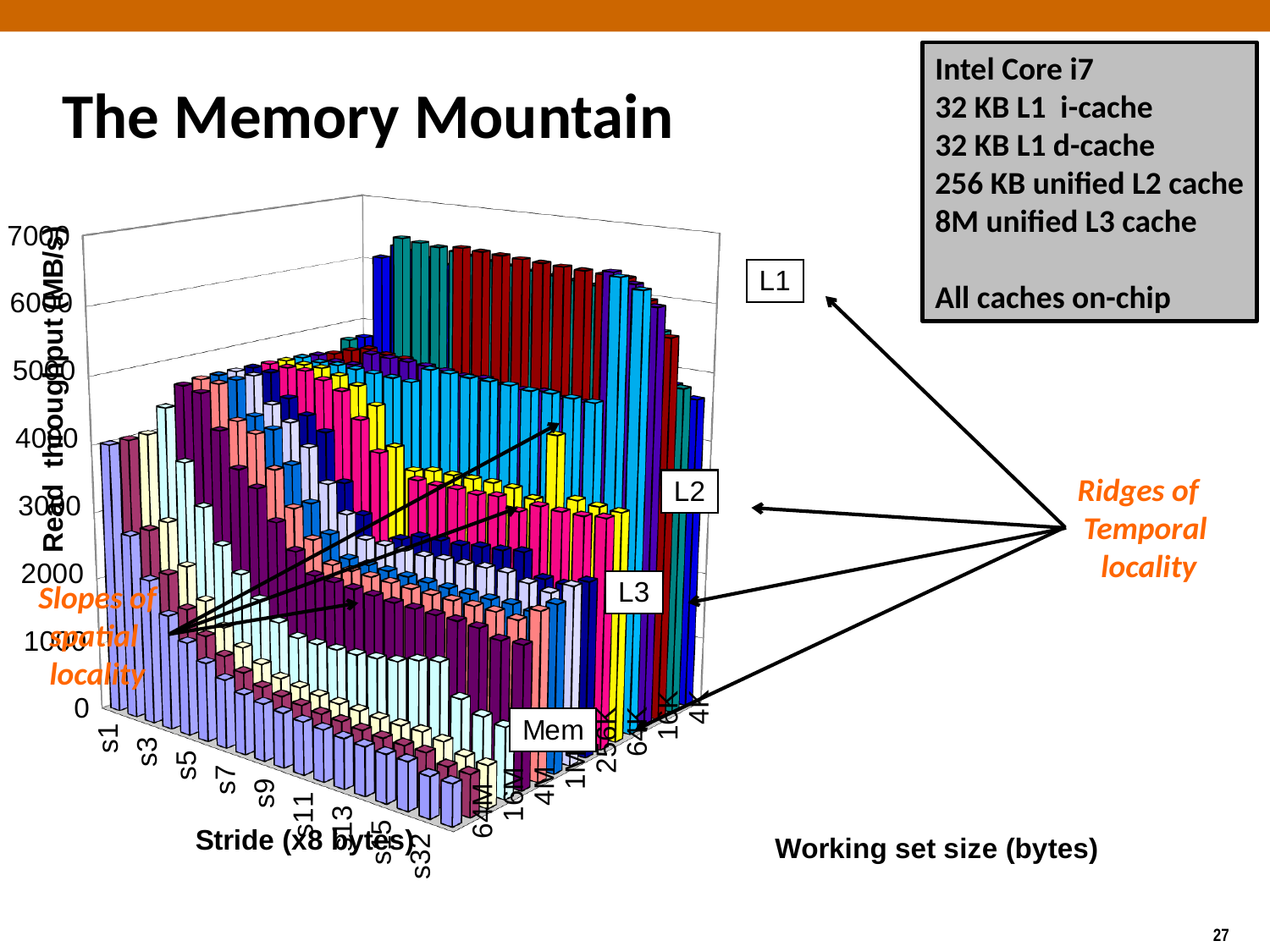
For the 64M working set size, does read throughput rise or fall as the stride increases from s1 to s32? fall What is the label of the stride axis of the chart? Stride (x8 bytes) Which is larger: the bar for stride s1 at working set size 64M or the bar for stride s32 at working set size 64M? s1 at 64M Is the tallest bar in the chart greater or less than 6000? greater Is the bar for stride s32 at working set size 64M greater or less than 2000? less What kind of chart is shown on the slide? bar chart What is the label of the vertical axis of the chart? Read throughput (MB/s) What is the highest tick value shown on the vertical axis? 7000